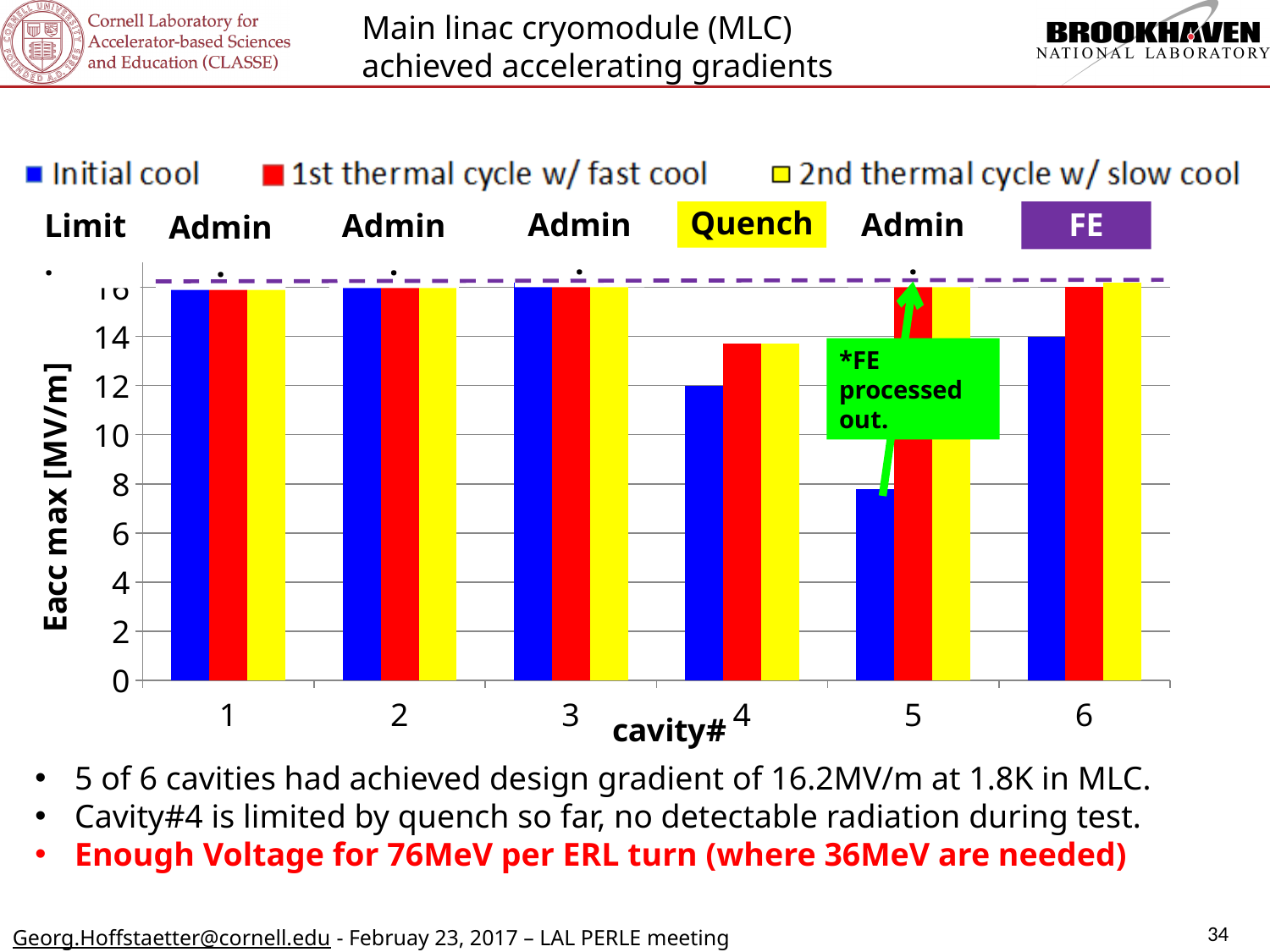
Is the 2nd thermal cycle w/ slow cool value for cavity 5 greater or less than 14? greater Is the Initial cool value for cavity 4 greater or less than 14? less How many series does the chart legend list? 3 Which cavity has the lowest Initial cool value? 5 Which cavity has the lowest 1st thermal cycle w/ fast cool value? 4 What is the label of the y axis of the chart? Eacc max [MV/m] How many cavities are shown along the x axis of the chart? 6 Is the Initial cool value for cavity 5 greater or less than 10? less For cavity 6, which is larger: the Initial cool value or the 1st thermal cycle w/ fast cool value? 1st thermal cycle w/ fast cool What kind of chart is shown on the slide? bar chart